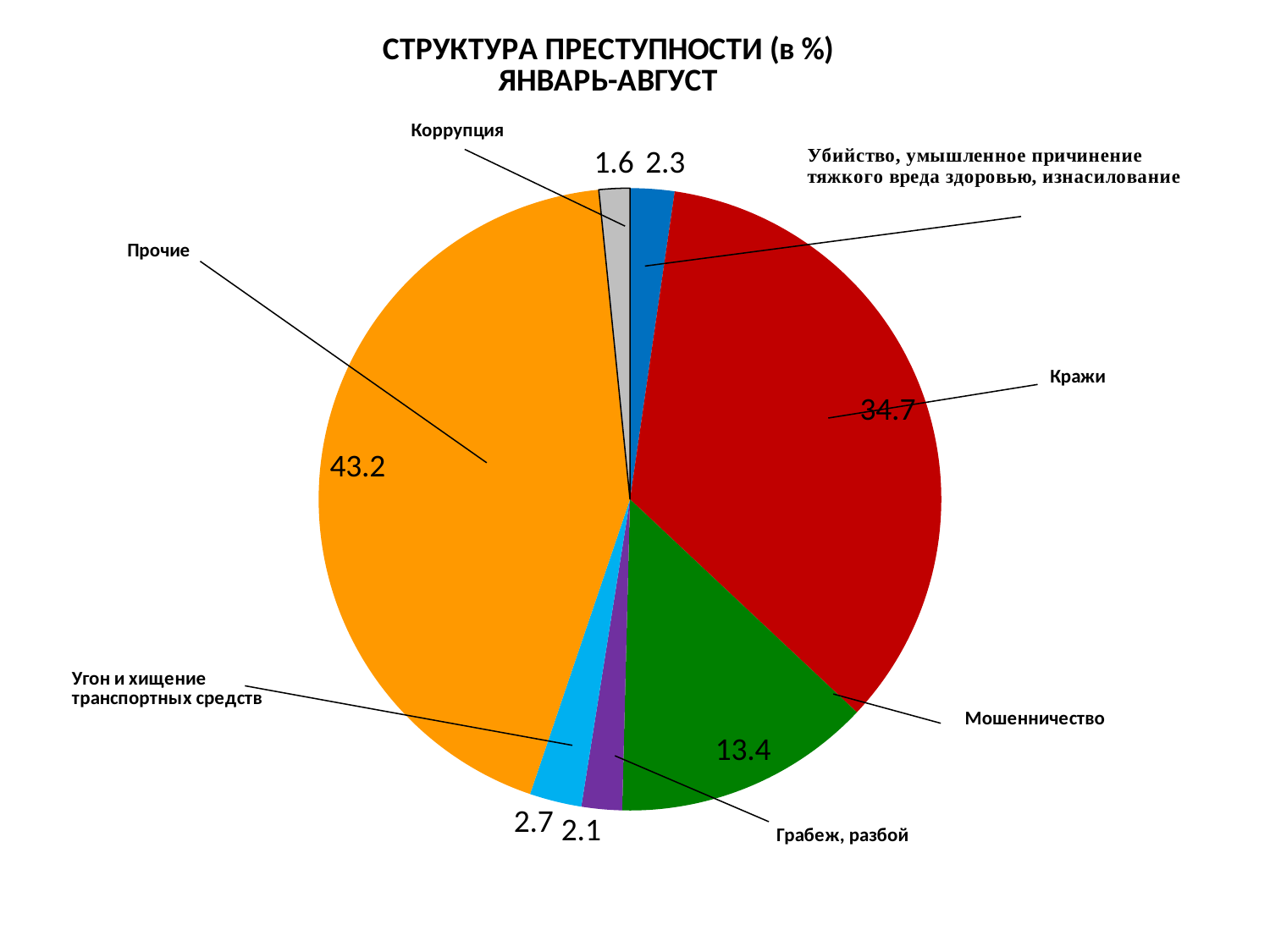
What is the value for Угон и хищение транспортных средств? 2.7 What is the value for Грабеж, разбой? 2.1 What is the value for Коррупция? 1.6 Which category has the largest slice of the pie? Прочие What colour is the slice for Кражи? red What is the value for Кражи? 34.7 What is the value for Мошенничество? 13.4 Which category has the smallest slice of the pie? Коррупция What is the difference between the values for Прочие and Кражи? 8.5 What type of chart is shown on the slide? pie chart Which is larger, the value for Мошенничество or the value for Кражи? Кражи How many slices does the pie chart have? 7